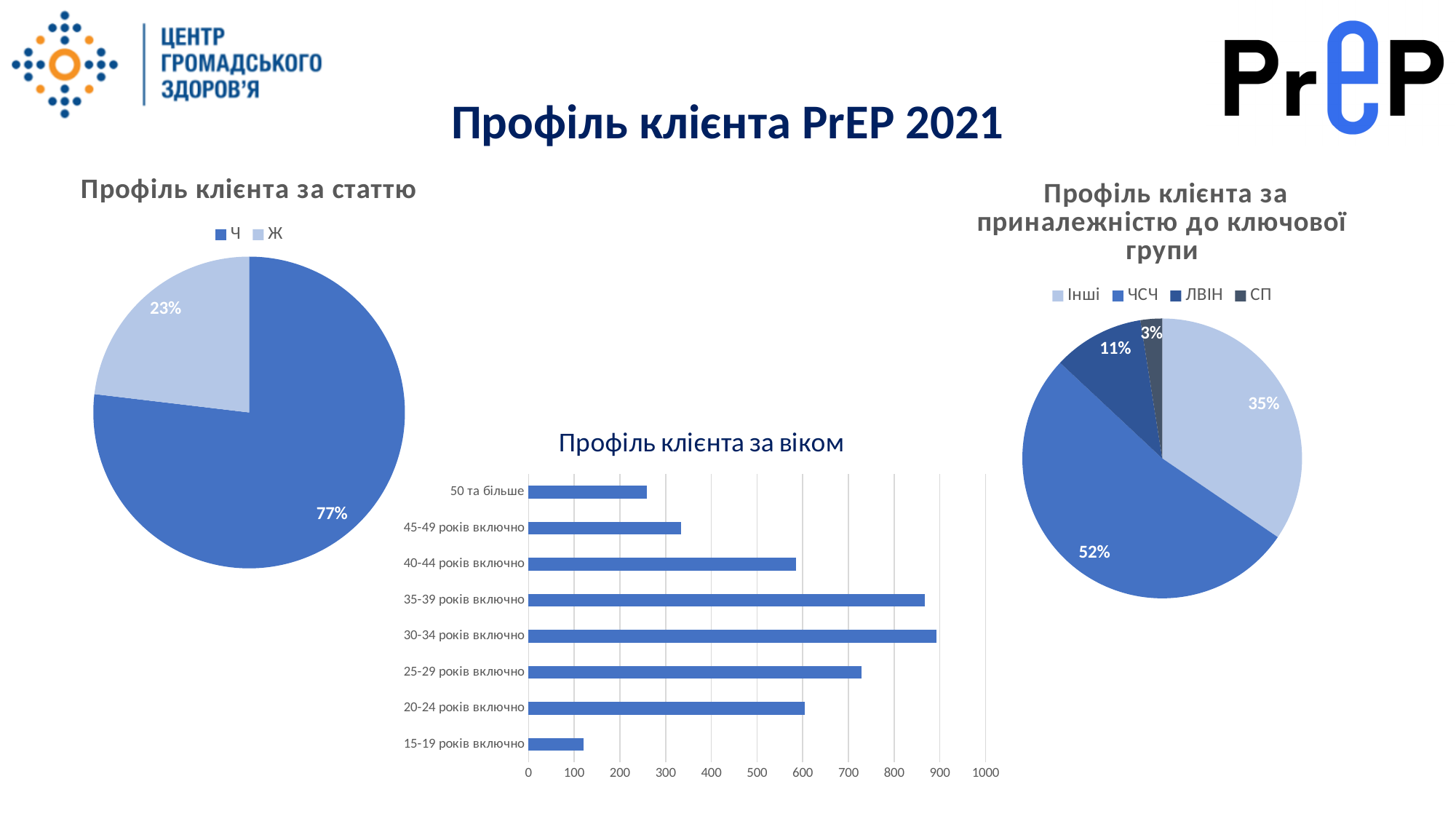
In the pie chart 'Профіль клієнта за приналежністю до ключової групи', what share is labelled for ЧСЧ? 52% In the chart 'Профіль клієнта за віком', is the value for '15-19 років включно' greater or less than 200? less In the chart 'Профіль клієнта за віком', is the value for '35-39 років включно' greater or less than 800? greater In the pie chart 'Профіль клієнта за статтю', what share is labelled for Ж? 23% In the pie chart 'Профіль клієнта за приналежністю до ключової групи', what is the difference between the shares of Інші and ЛВІН? 24% In the chart 'Профіль клієнта за віком', which age category has the lowest value? 15-19 років включно In the pie chart 'Профіль клієнта за статтю', what share is labelled for Ч? 77% In the chart 'Профіль клієнта за віком', which is larger: the value for '25-29 років включно' or '20-24 років включно'? 25-29 років включно What kind of chart is 'Профіль клієнта за віком'? bar chart How many age categories are shown in the chart 'Профіль клієнта за віком'? 8 How many entries does the legend of the chart 'Профіль клієнта за приналежністю до ключової групи' list? 4 In the pie chart 'Профіль клієнта за приналежністю до ключової групи', which category has the smallest share? СП